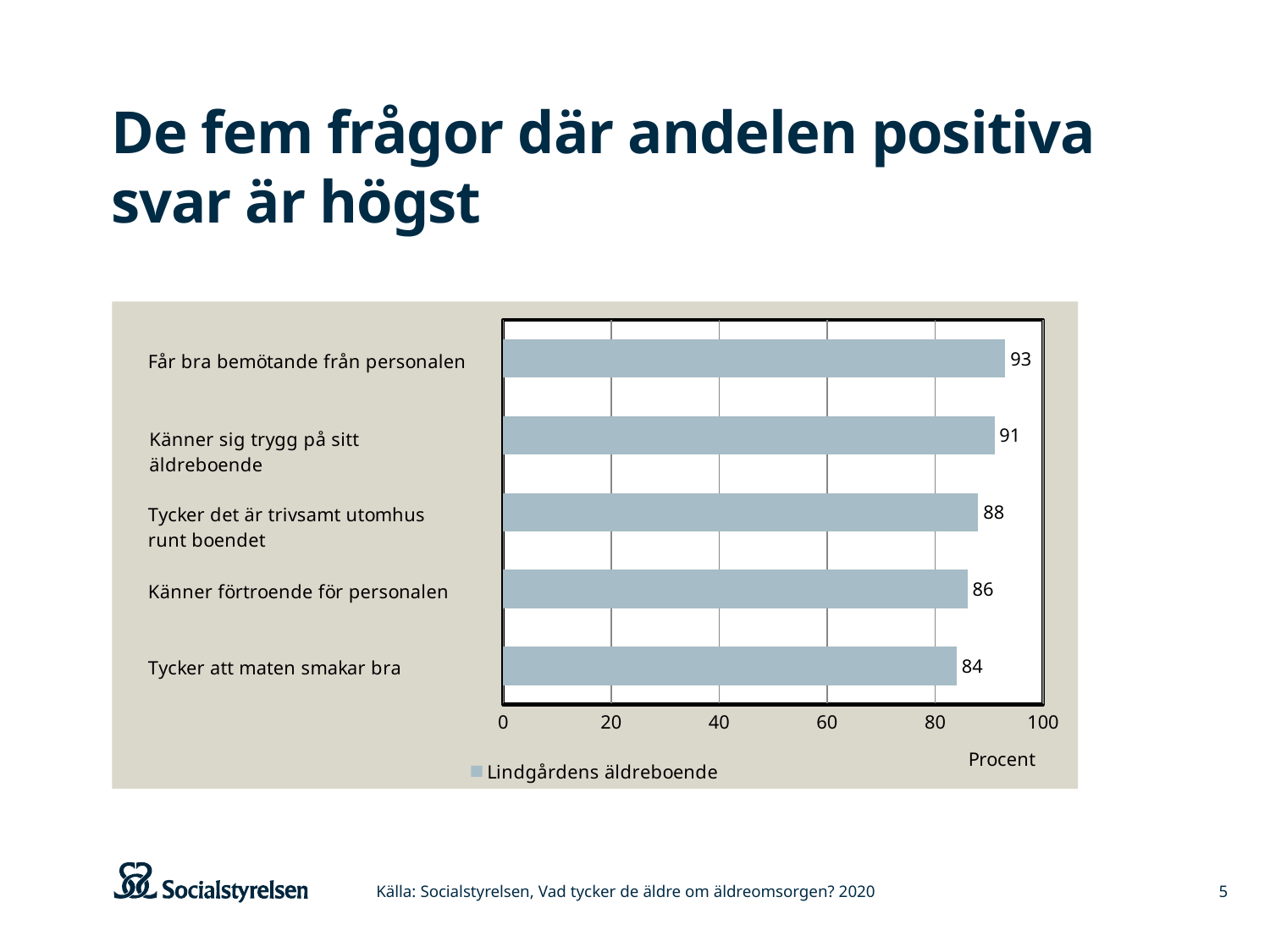
How many categories are shown in the chart? 5 What kind of chart is shown on the slide? bar chart What is the value for "Känner förtroende för personalen"? 86 What is the value for "Får bra bemötande från personalen"? 93 Which category has the lowest value? Tycker att maten smakar bra How many series does the legend list? 1 What is the name of the series shown in the legend? Lindgårdens äldreboende Is the value for "Tycker det är trivsamt utomhus runt boendet" greater or less than 80? greater What is the value for "Tycker att maten smakar bra"? 84 Which category has the highest value? Får bra bemötande från personalen What is the difference between the values for "Känner sig trygg på sitt äldreboende" and "Tycker det är trivsamt utomhus runt boendet"? 3 Which is larger, the value for "Känner sig trygg på sitt äldreboende" or the value for "Känner förtroende för personalen"? Känner sig trygg på sitt äldreboende